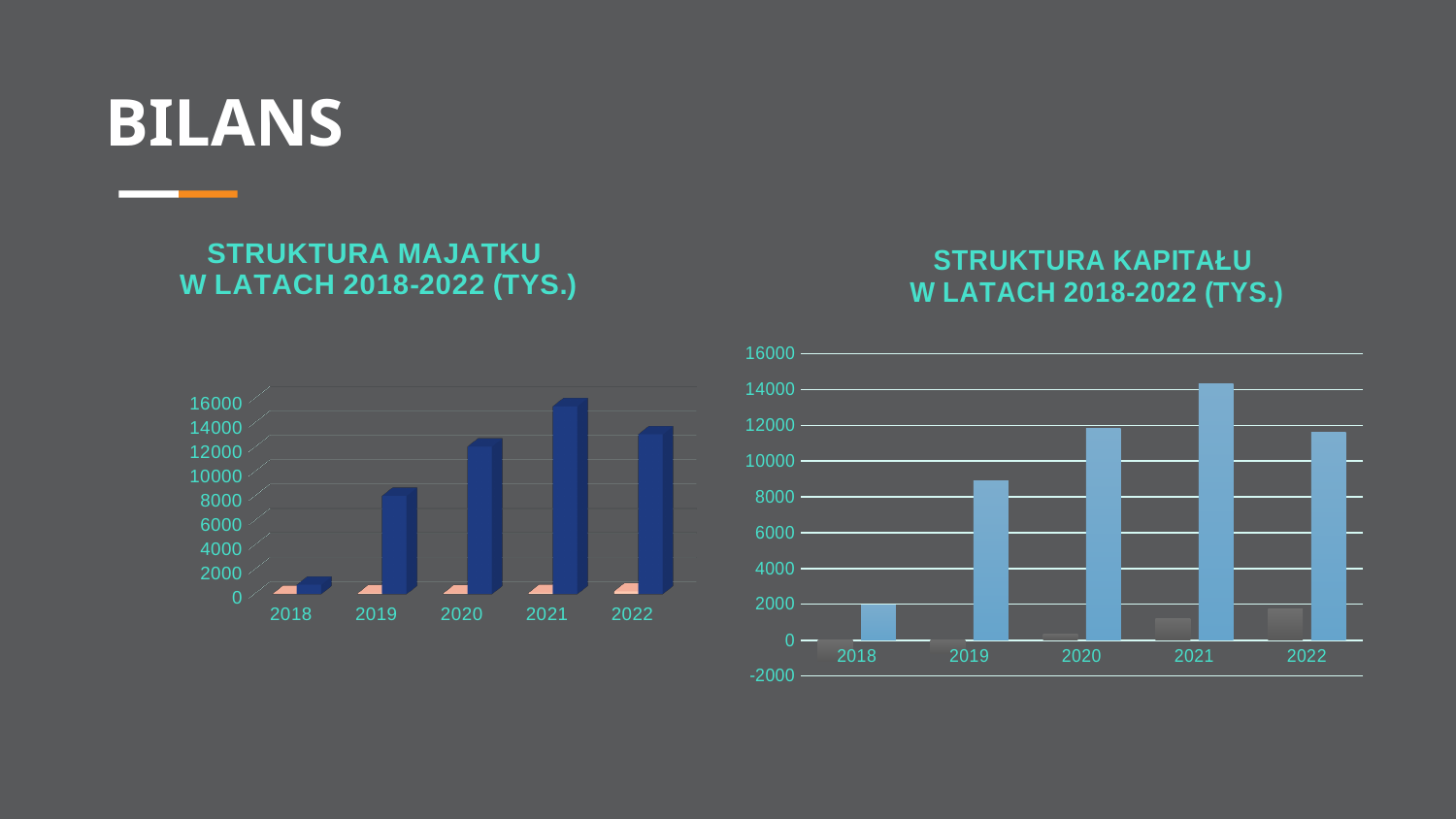
What kind of chart is the 'STRUKTURA MAJATKU W LATACH 2018-2022 (TYS.)' chart on the left? bar chart In the right chart 'STRUKTURA KAPITAŁU', do the light blue bars rise or fall from 2018 to 2021? rise In the right chart 'STRUKTURA KAPITAŁU', which light blue bar is taller, 2021 or 2022? 2021 In the left chart 'STRUKTURA MAJATKU', which year has the tallest dark blue bar? 2021 In the right chart 'STRUKTURA KAPITAŁU', is the light blue bar for 2018 greater or less than 4000? less What kind of chart is the 'STRUKTURA KAPITAŁU W LATACH 2018-2022 (TYS.)' chart on the right? bar chart In the left chart 'STRUKTURA MAJATKU', is the dark blue bar for 2021 greater or less than 14000? greater In the left chart 'STRUKTURA MAJATKU', which year has the shortest dark blue bar? 2018 In the right chart 'STRUKTURA KAPITAŁU', how many years are shown on the x axis? 5 In the right chart 'STRUKTURA KAPITAŁU', which year has the tallest light blue bar? 2021 In the left chart 'STRUKTURA MAJATKU', how many years are shown on the x axis? 5 In the right chart 'STRUKTURA KAPITAŁU', which year has the shortest light blue bar? 2018